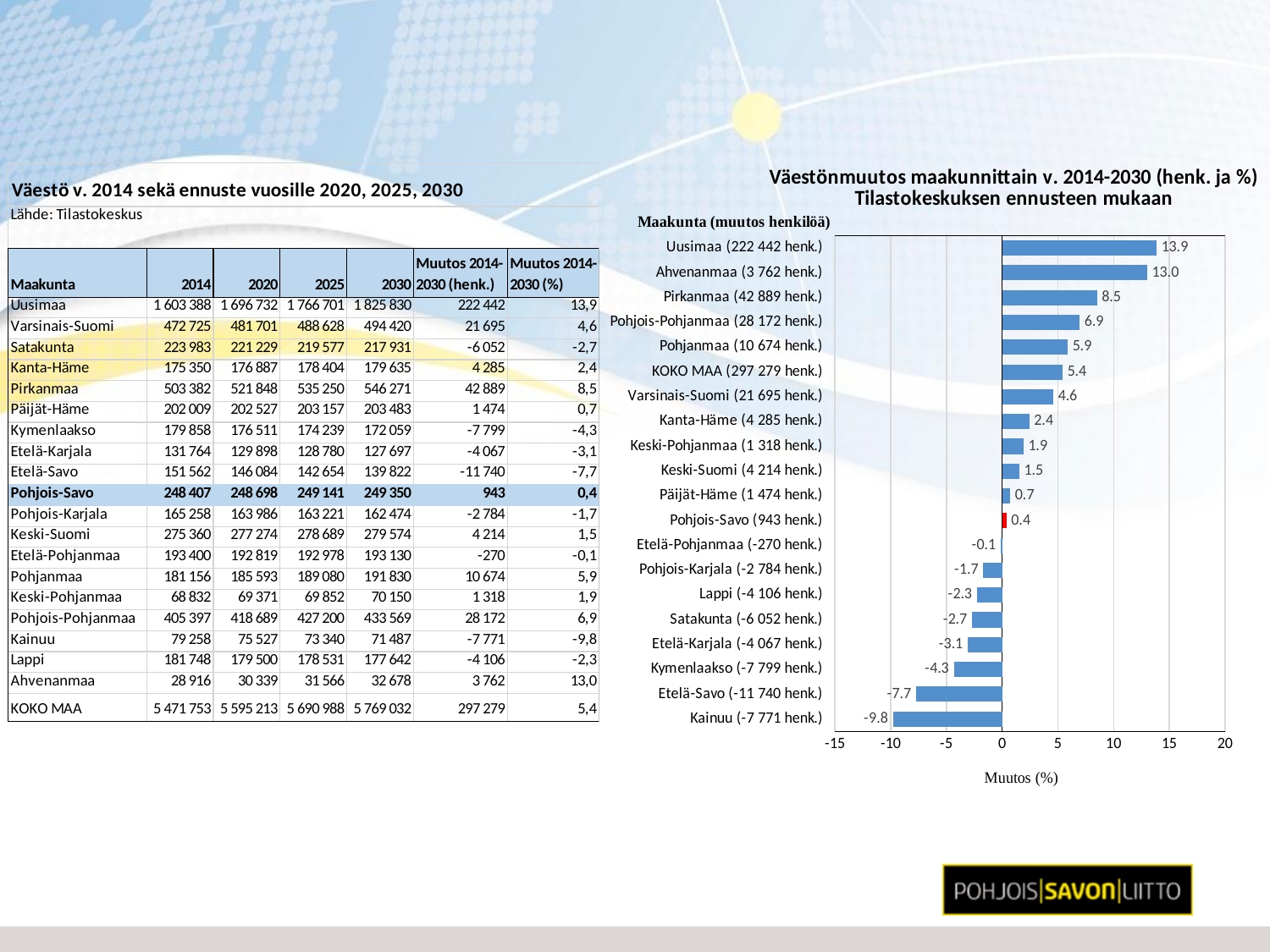
How many bars (regions) are shown in the bar chart? 20 In the bar chart, is the value for Etelä-Savo greater or less than -5? less What type of chart is shown on the right side of the slide? Bar chart In the bar chart, what is the percentage change shown for Pohjois-Savo? 0.4 In the bar chart, what is the percentage change shown for KOKO MAA? 5.4 In the bar chart, what is the percentage change shown for Kainuu? -9.8 In the bar chart, what is the difference between the percentage change for Uusimaa and Ahvenanmaa? 0.9 In the bar chart, which has a larger percentage change, Pirkanmaa or Pohjanmaa? Pirkanmaa Which region has the lowest percentage change in the bar chart? Kainuu In the bar chart, which bar is coloured red instead of blue? Pohjois-Savo In the bar chart, what is the percentage change shown for Uusimaa? 13.9 Which region has the highest percentage change in the bar chart? Uusimaa